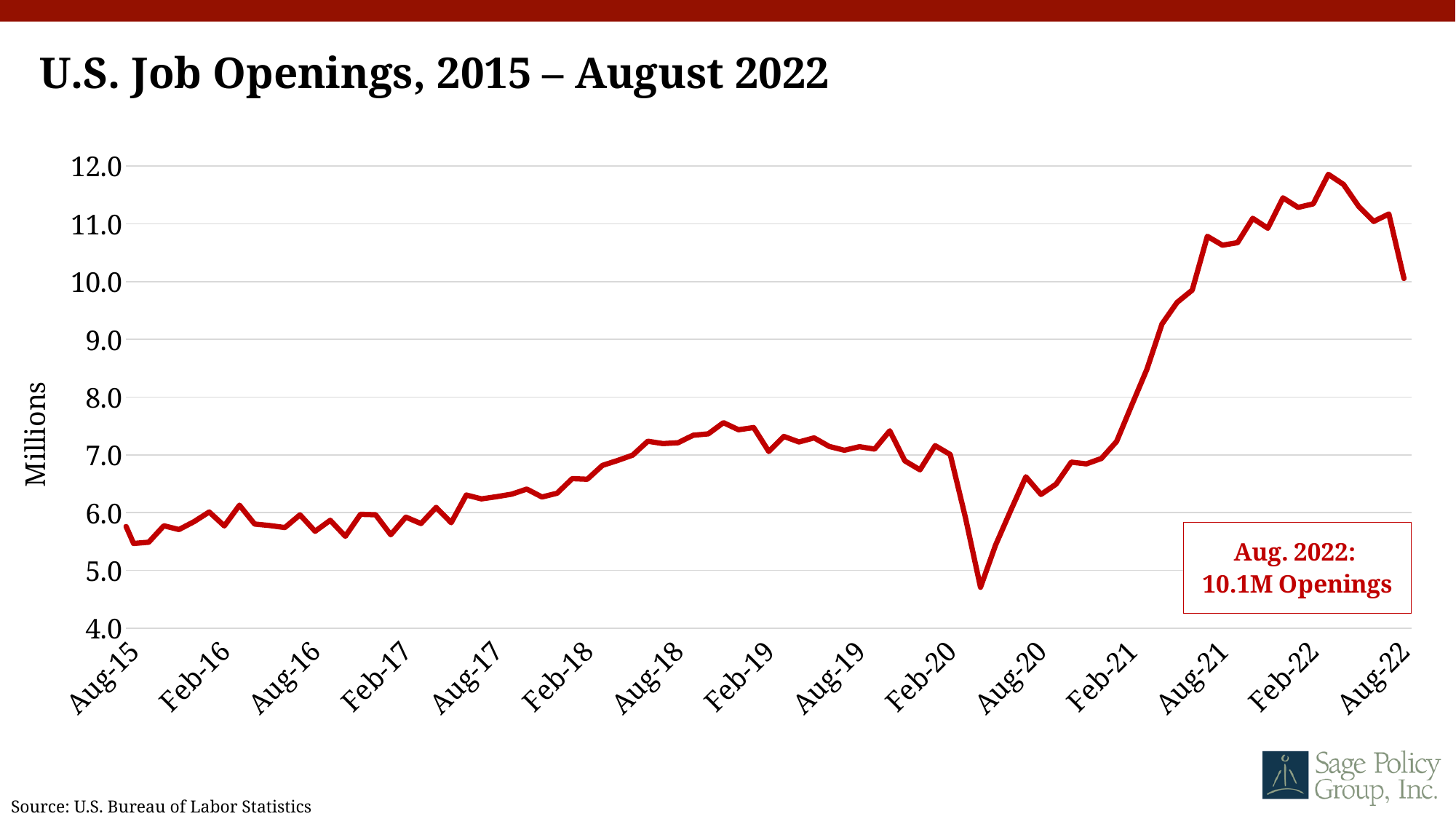
According to the callout on the chart, how many job openings were there in August 2022? 10.1M What is the title of the chart? U.S. Job Openings, 2015 – August 2022 Is the value for Aug-15 greater or less than 7.0 million? less Is the lowest point on the line greater or less than 5.0 million? less What unit is shown on the y axis? Millions Does the line rise or fall between Feb-22 and Aug-22? Fall What kind of chart is shown on the slide? Line chart How many date labels are shown on the x axis? 15 Is the value for Aug-18 greater or less than 8.0 million? less Which is larger, the value for Aug-15 or the value for Aug-22? Aug-22